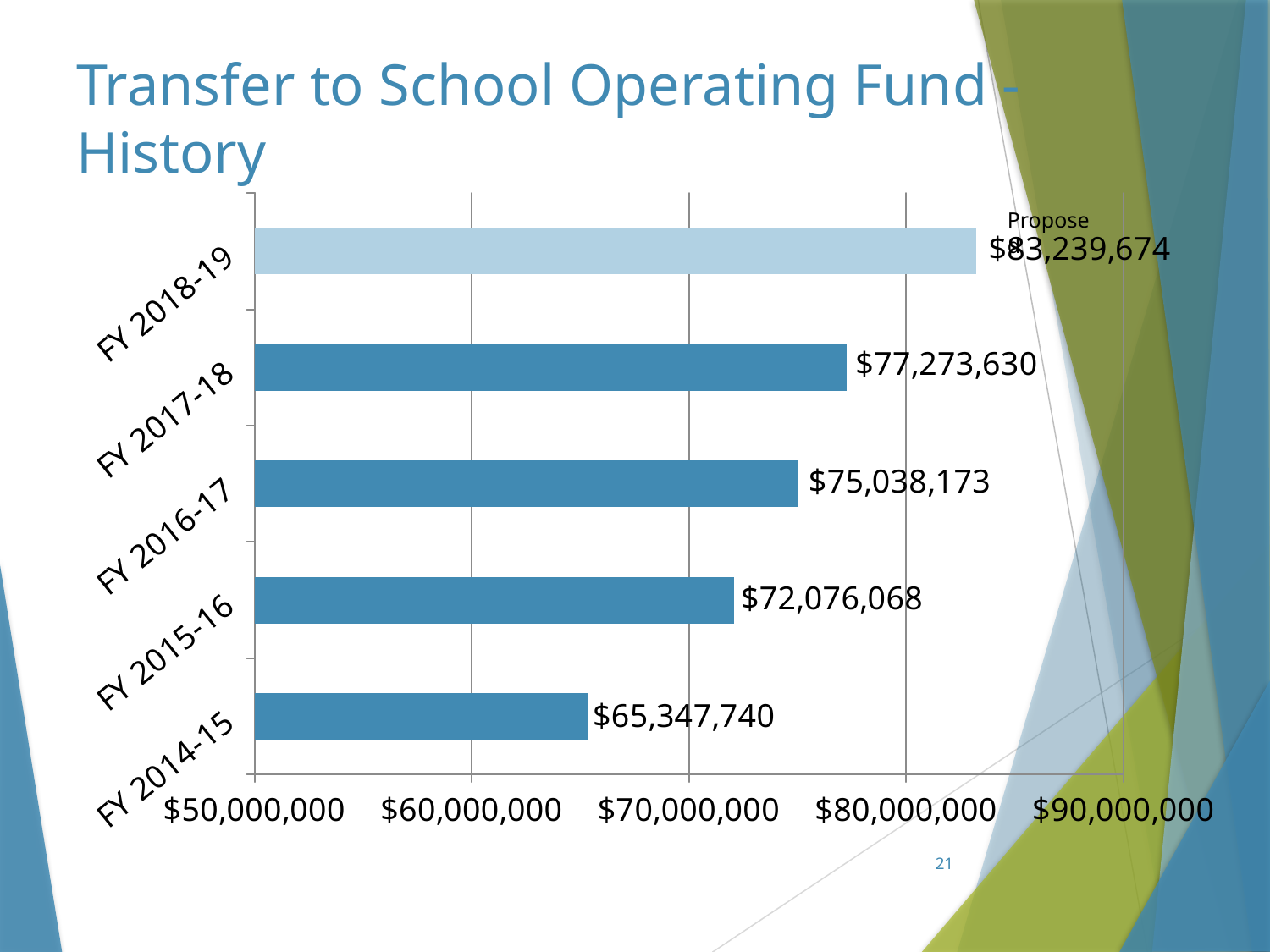
What is the difference between the FY 2015-16 and FY 2014-15 values? $6,728,328 Which fiscal year has the highest transfer value? FY 2018-19 What is the value for FY 2017-18? $77,273,630 Do the transfer values rise or fall from FY 2014-15 to FY 2018-19? Rise Which fiscal year has the lowest transfer value? FY 2014-15 Which is larger, the value for FY 2016-17 or FY 2015-16? FY 2016-17 What is the value for FY 2014-15? $65,347,740 What kind of chart is shown on the slide? Bar chart How many fiscal years are shown in the chart? 5 What is the value for FY 2015-16? $72,076,068 What is the value for FY 2016-17? $75,038,173 What is the difference between the FY 2017-18 and FY 2016-17 values? $2,235,457